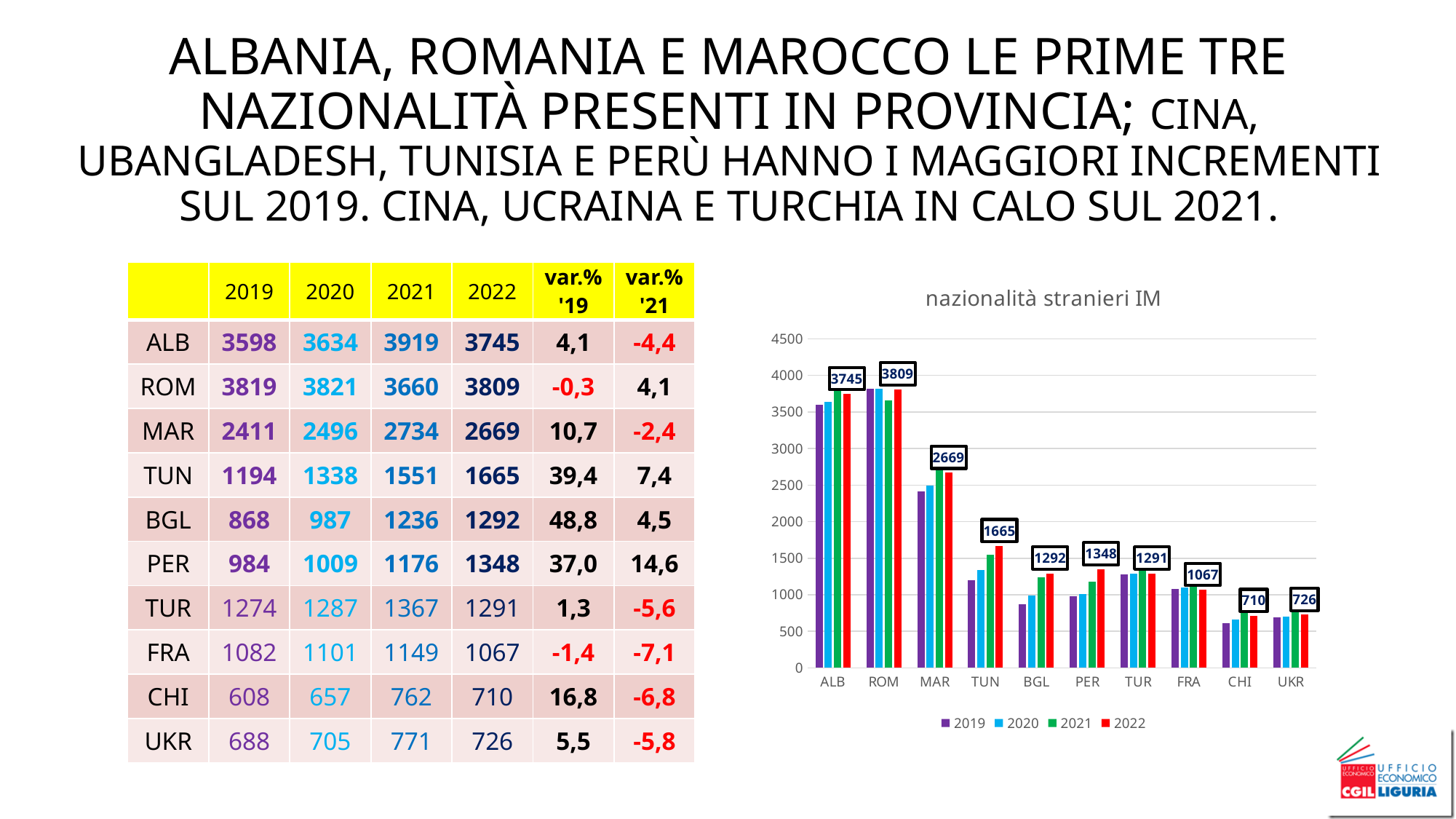
What is the 2022 value for TUN in the chart? 1665 What is the difference between the 2022 values for ALB and MAR in the chart? 1076 What is the 2022 value for ROM in the chart? 3809 What is the title of the chart? nazionalità stranieri IM Which category has the lowest 2022 value in the chart? CHI How many nationality categories are shown on the x axis of the chart? 10 Which colour represents the 2022 series in the chart? red Which is larger in the chart, the 2022 value for PER or the 2022 value for BGL? PER Which category has the highest 2022 value in the chart? ROM Is the 2019 value for MAR in the chart greater or less than 2500? less What type of chart is shown on the slide? bar chart How many series does the chart legend list? 4